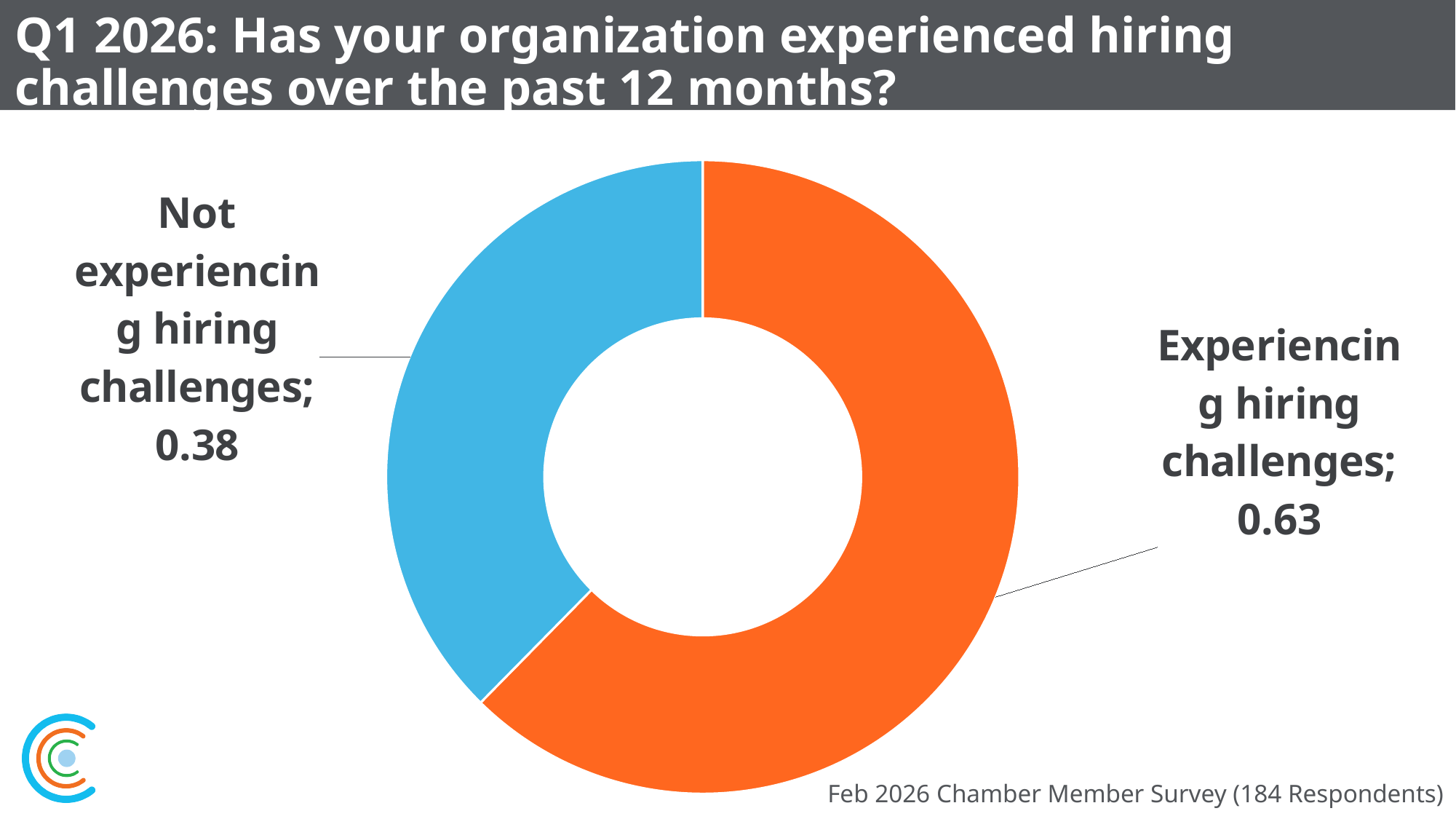
What colour is the "Experiencing hiring challenges" slice? Orange What is the difference between the values for "Experiencing hiring challenges" and "Not experiencing hiring challenges"? 0.25 What value is shown for "Not experiencing hiring challenges"? 0.38 Which is larger: the value for "Experiencing hiring challenges" or for "Not experiencing hiring challenges"? Experiencing hiring challenges What value is shown for "Experiencing hiring challenges"? 0.63 What kind of chart is shown on the slide? Pie chart (doughnut) How many respondents does the survey note at the bottom of the slide mention? 184 Which category has the largest share of the chart? Experiencing hiring challenges Which category has the smallest share of the chart? Not experiencing hiring challenges How many categories are shown in the chart? 2